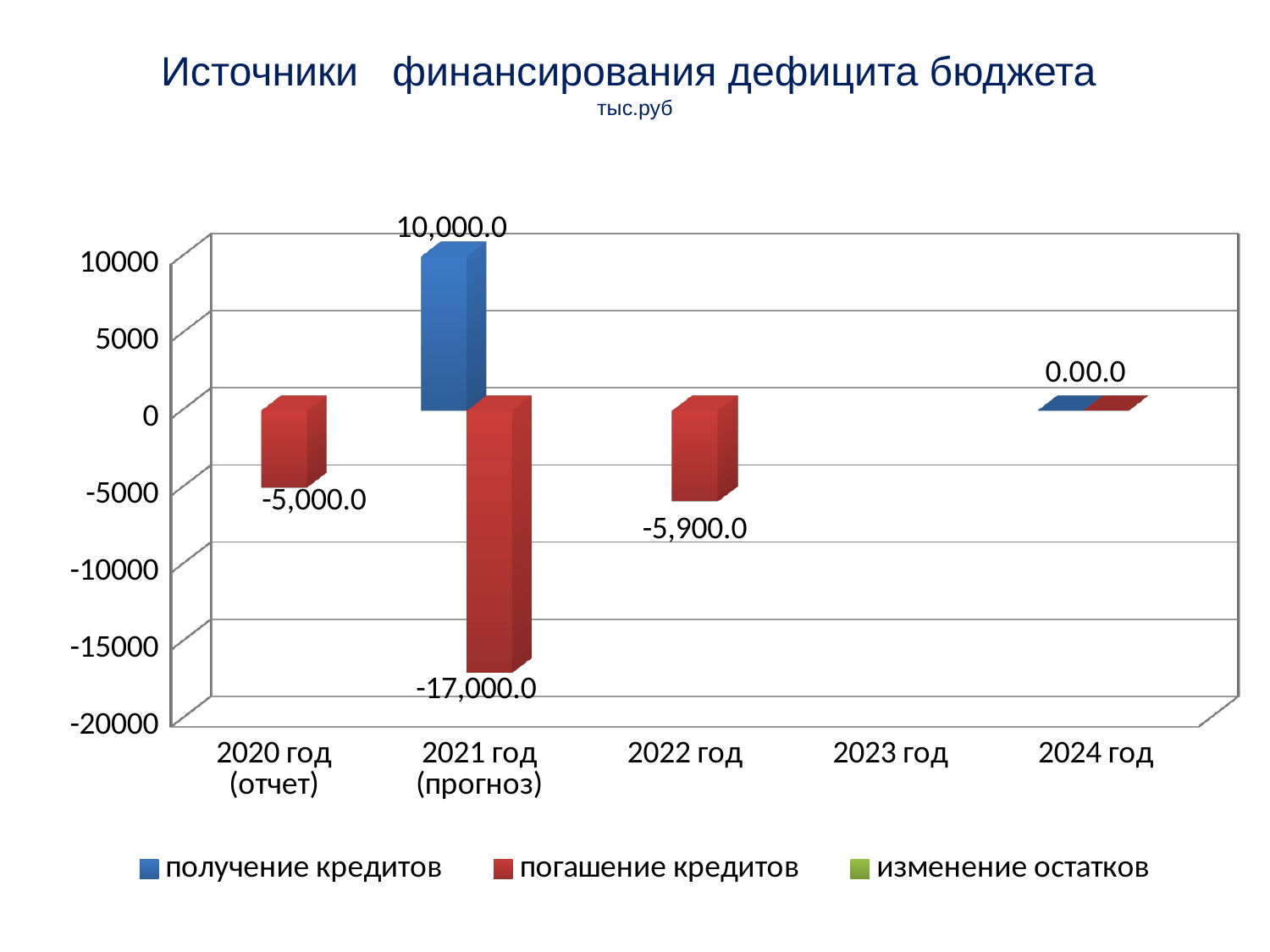
How many year categories are shown on the x axis? 5 What is the difference between получение кредитов and погашение кредитов in 2021 год (прогноз)? 27,000.0 In which year is the value of погашение кредитов the lowest? 2021 год (прогноз) What kind of chart is shown on the slide? bar chart Is the value of погашение кредитов for 2021 год (прогноз) greater or less than -15000? less What is the value of получение кредитов for 2021 год (прогноз)? 10,000.0 What is the value of погашение кредитов for 2022 год? -5,900.0 Which is lower, погашение кредитов for 2020 год (отчет) or for 2022 год? 2022 год What is the value of погашение кредитов for 2020 год (отчет)? -5,000.0 What colour represents получение кредитов in the legend? blue What is the value of погашение кредитов for 2021 год (прогноз)? -17,000.0 How many series does the legend list? 3